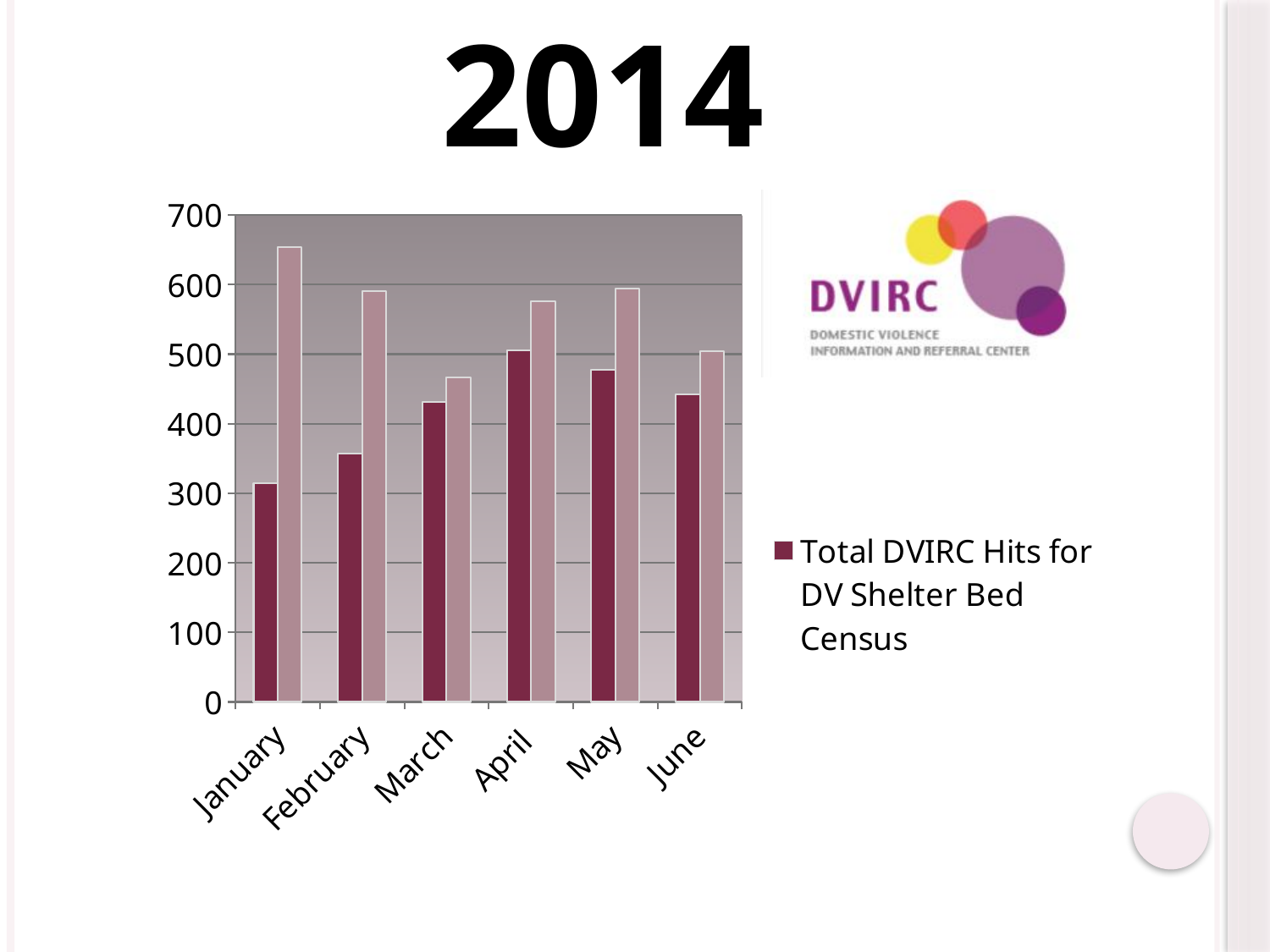
Is the value for Total DVIRC Hits for DV Shelter Bed Census in June greater or less than 500? less Is the value for Total DVIRC Hits for DV Shelter Bed Census in January greater or less than 400? less How many months are shown on the x axis of the chart? 6 Does the value for Total DVIRC Hits for DV Shelter Bed Census rise or fall from January to April? rise Which month has a larger value for Total DVIRC Hits for DV Shelter Bed Census, February or March? March Which month has the highest value for Total DVIRC Hits for DV Shelter Bed Census? April What is the series name shown in the chart's legend? Total DVIRC Hits for DV Shelter Bed Census What is the title shown above the chart? 2014 Which month has the lowest value for Total DVIRC Hits for DV Shelter Bed Census? January Is the value for Total DVIRC Hits for DV Shelter Bed Census in March greater or less than 400? greater How many series does the chart's legend list? 1 What kind of chart is shown on the slide? bar chart